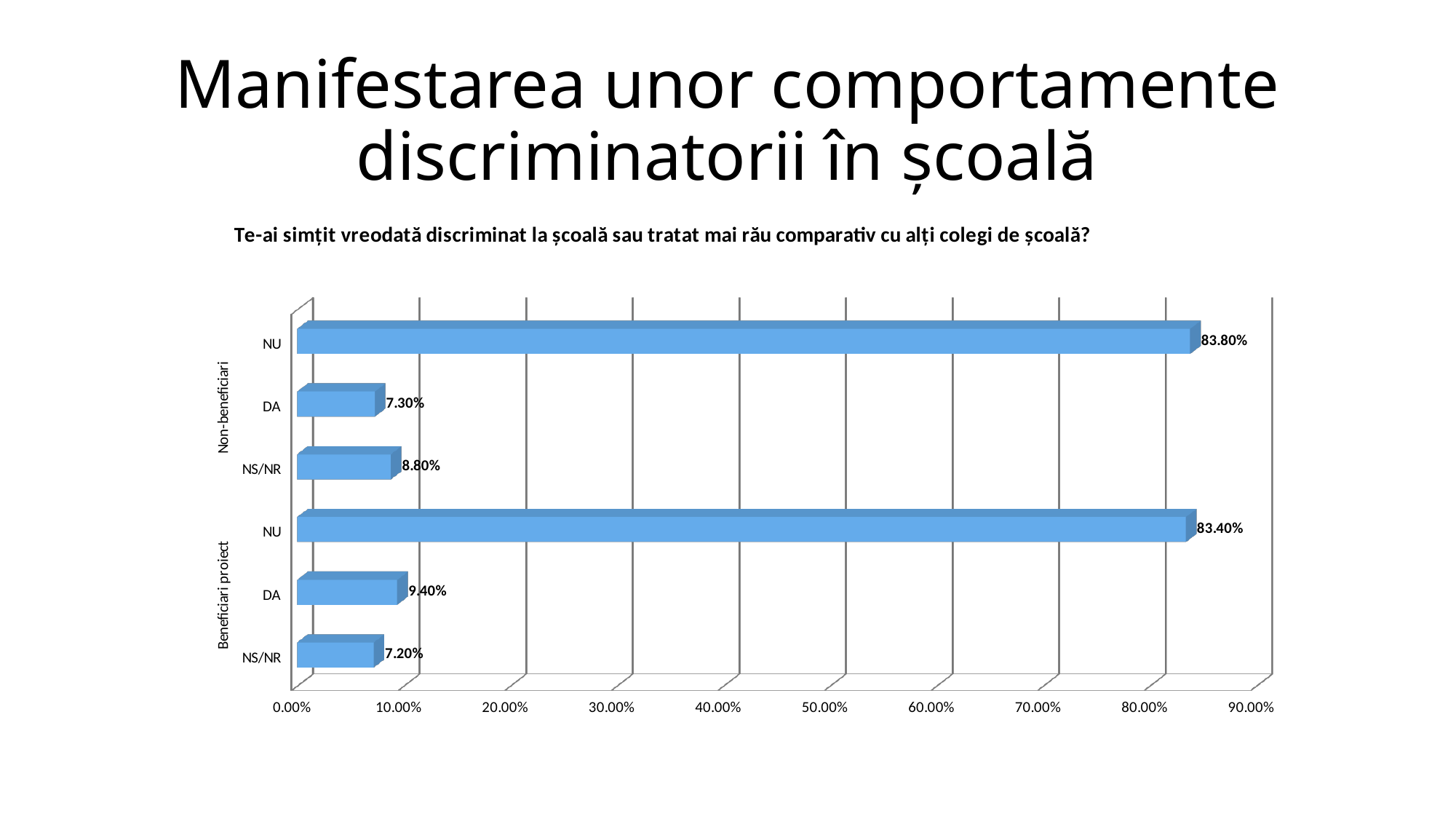
Which bar has the highest value on the chart? NU (Non-beneficiari) What is the difference between the NU values for Non-beneficiari and Beneficiari proiect? 0.40% Which is larger: DA for Non-beneficiari or NS/NR for Non-beneficiari? NS/NR for Non-beneficiari What is the value for NS/NR in the Beneficiari proiect group? 7.20% Is the value for NU in the Beneficiari proiect group greater or less than 80.00%? greater How many bars are plotted on the chart? 6 What kind of chart is shown on the slide? bar chart Which bar has the lowest value on the chart? NS/NR (Beneficiari proiect) What is the value for NS/NR in the Non-beneficiari group? 8.80% What is the value for NU in the Non-beneficiari group? 83.80% What is the difference between DA for Beneficiari proiect and DA for Non-beneficiari? 2.10% What is the value for DA in the Beneficiari proiect group? 9.40%